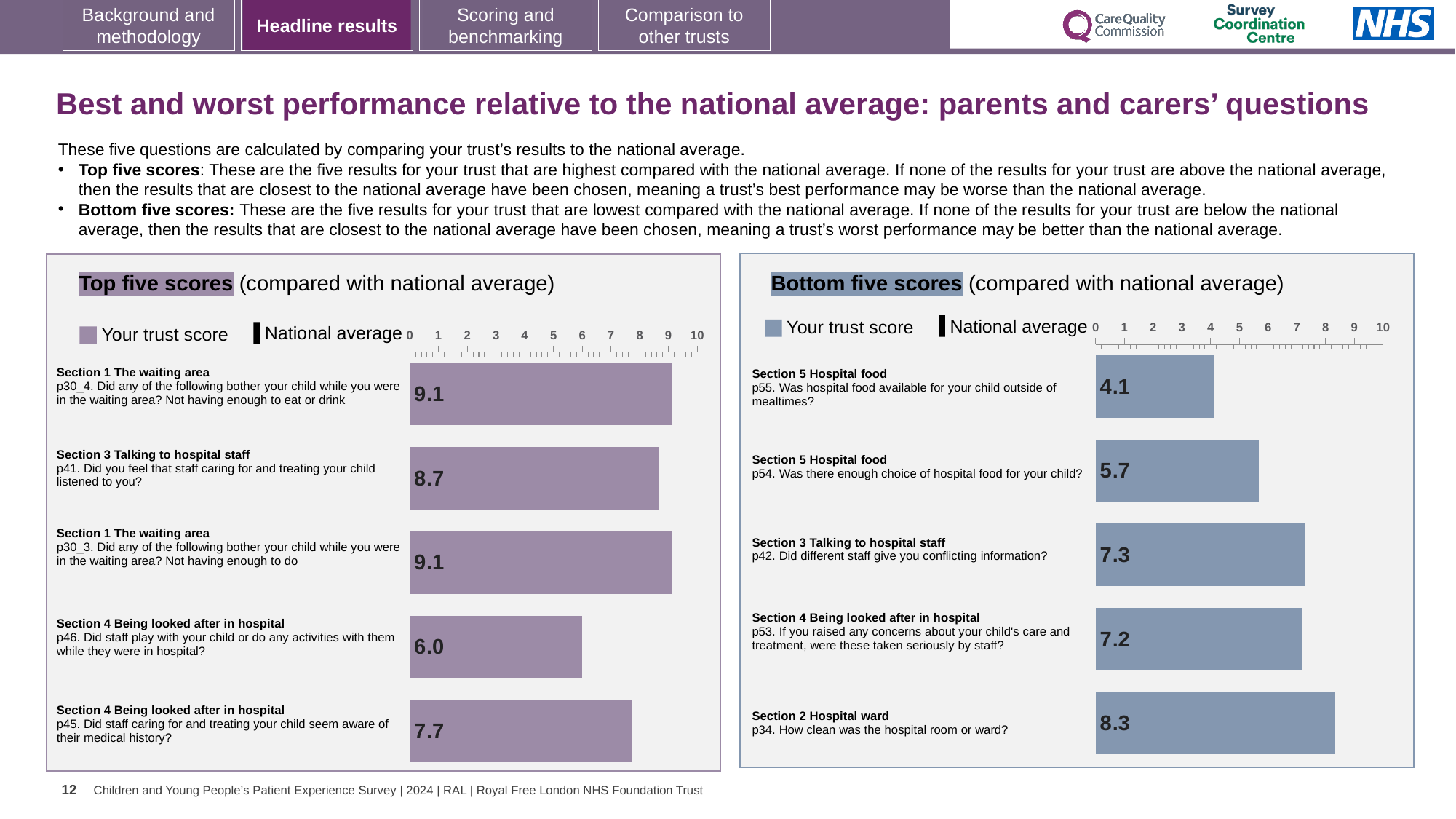
In the 'Bottom five scores' chart, which question has the lowest trust score? p55. Was hospital food available for your child outside of mealtimes? In the 'Bottom five scores' chart, which question has the highest trust score? p34. How clean was the hospital room or ward? In the 'Bottom five scores' chart, what is the difference between the trust scores for p34 and p55? 4.2 How many questions are shown in the 'Bottom five scores' chart? 5 In the 'Bottom five scores' chart, which has the larger trust score: p54 or p42? p42 In the 'Bottom five scores' chart, what is the trust score for p34 (How clean was the hospital room or ward?)? 8.3 In the 'Top five scores' chart, what is the trust score for p41 (Did you feel that staff caring for and treating your child listened to you?)? 8.7 In the 'Top five scores' chart, what is the trust score for p46 (Did staff play with your child or do any activities with them while they were in hospital?)? 6.0 In the 'Bottom five scores' chart, what is the trust score for p55 (Was hospital food available for your child outside of mealtimes?)? 4.1 What type of chart is the 'Top five scores' chart? Bar chart In the 'Top five scores' chart, which question has the lowest trust score? p46. Did staff play with your child or do any activities with them while they were in hospital? In the 'Top five scores' chart, what is the difference between the trust scores for p30_4 and p45? 1.4